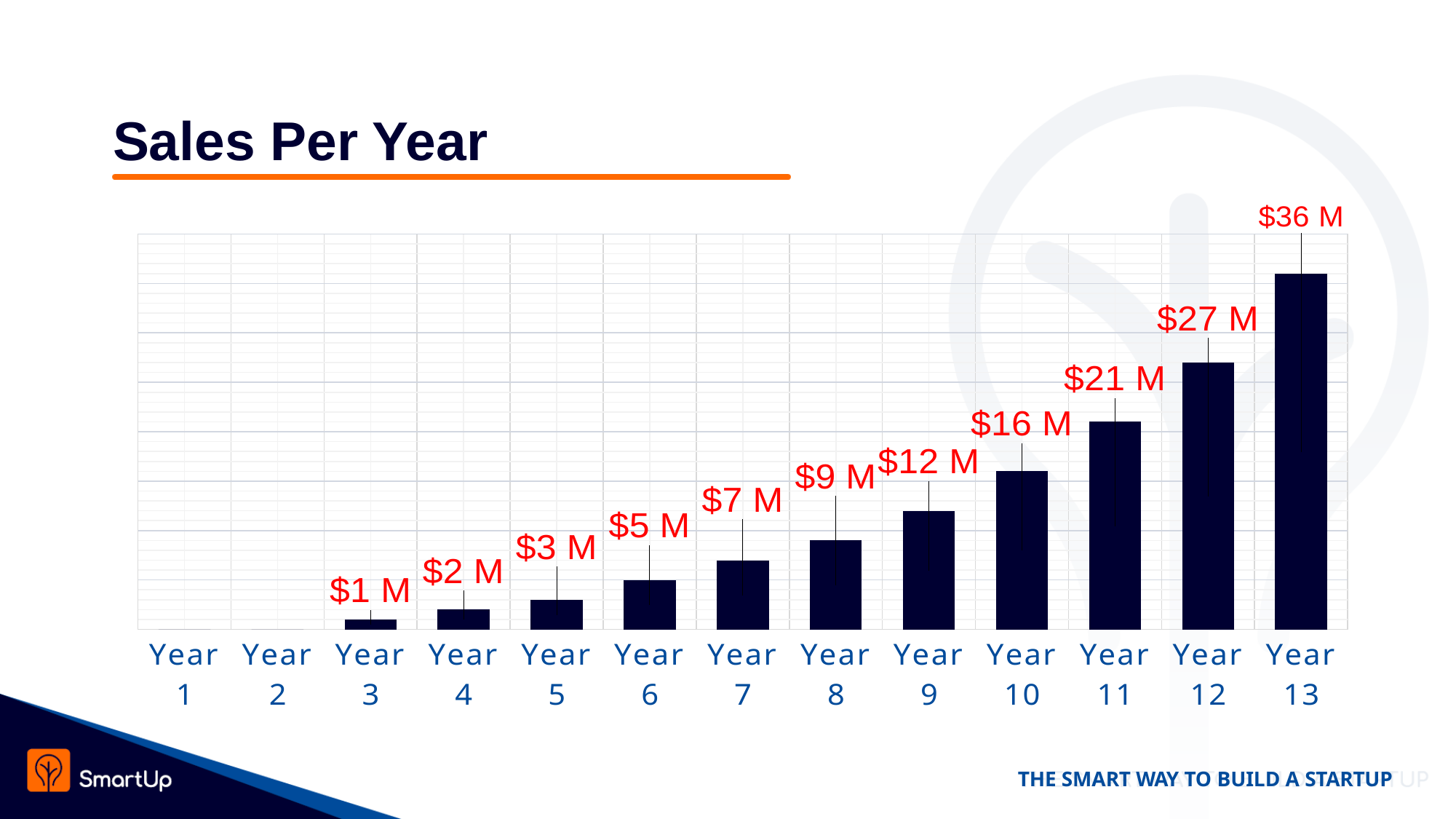
What is the difference in sales between Year 10 and Year 7? $9 M What is the sales value for Year 11? $21 M Do sales rise or fall from Year 3 to Year 13? Rise How many years are shown on the x axis? 13 What is the sales value for Year 8? $9 M What is the sales value for Year 3? $1 M What is the difference in sales between Year 13 and Year 12? $9 M What is the title of the chart? Sales Per Year What kind of chart is shown on the slide? Bar chart What is the sales value for Year 13? $36 M Which is larger, the sales for Year 9 or Year 6? Year 9 Which year has the highest sales? Year 13